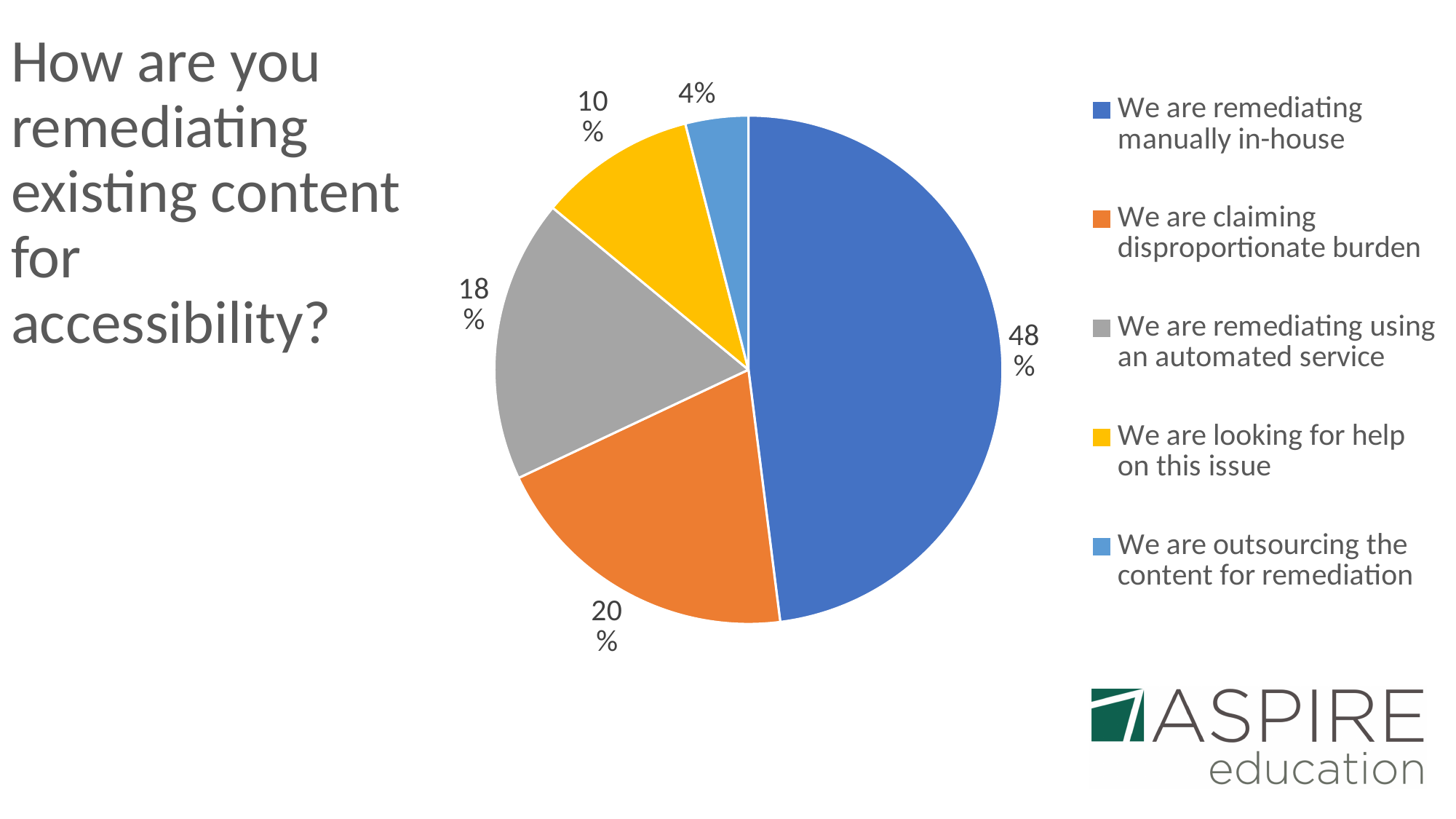
Which category has the largest slice of the pie? We are remediating manually in-house What share of the pie is 'We are remediating manually in-house'? 48% What colour is the slice for 'We are remediating using an automated service'? grey What is the difference in percentage points between 'We are remediating manually in-house' and 'We are claiming disproportionate burden'? 28 What kind of chart is shown on the slide? pie chart Which is larger: 'We are looking for help on this issue' or 'We are outsourcing the content for remediation'? We are looking for help on this issue Which category has the smallest slice of the pie? We are outsourcing the content for remediation How many categories does the pie chart have? 5 What share of the pie is 'We are remediating using an automated service'? 18% What share of the pie is 'We are outsourcing the content for remediation'? 4%